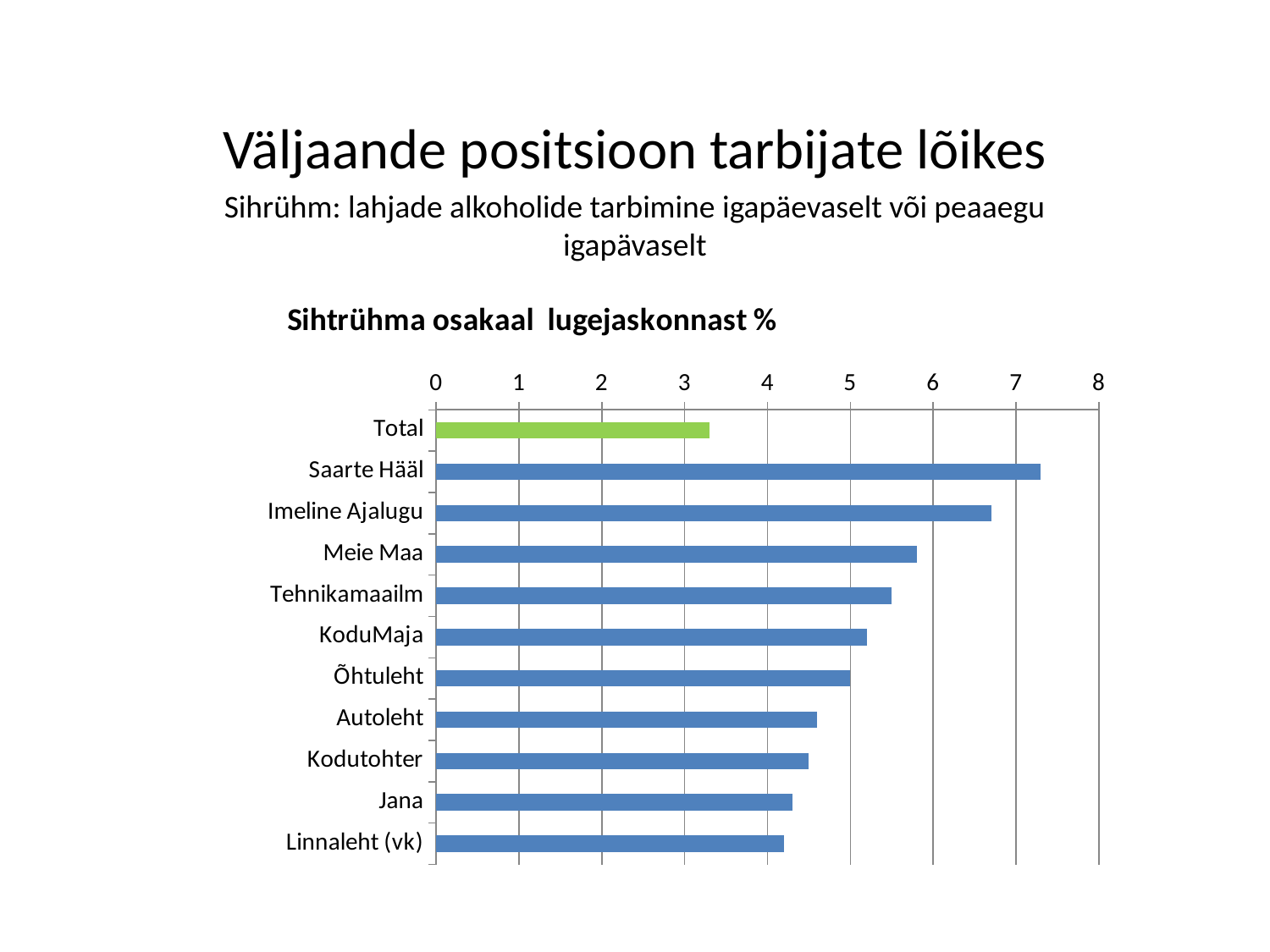
Is the value for Meie Maa greater or less than 5? greater Which category has the highest value in the chart? Saarte Hääl Is the value for Saarte Hääl greater or less than 7? greater Is the value for Imeline Ajalugu greater or less than 7? less What is the title of the chart? Sihtrühma osakaal lugejaskonnast % How many categories (bars) does the chart show? 11 Which category has the lowest value in the chart? Total What kind of chart is shown on the slide? bar chart Which has a larger value, Meie Maa or KoduMaja? Meie Maa Which bar is shown in a different colour (green) from the others? Total